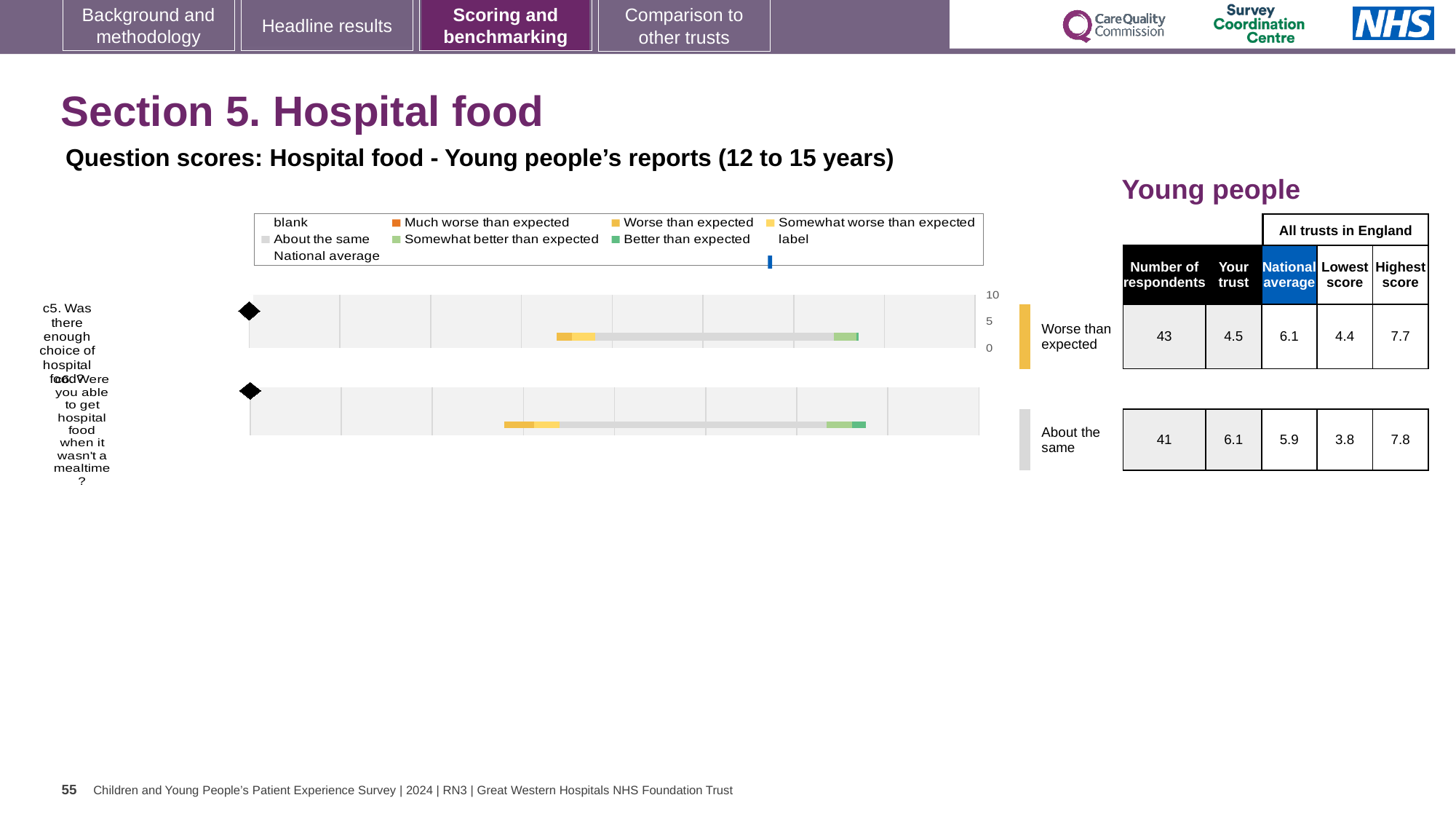
Which legend entry is shown with a blue marker in the chart legend? National average How many questions (bars) are plotted in the chart? 2 For question c6, is the 'Your trust' score or the national average score larger in the table beside the chart? Your trust What is the highest value shown on the chart's axis? 10 What is the difference between the highest score and the lowest score for question c5 in the table beside the chart? 3.3 What is the 'Your trust' score for question c5 in the table beside the chart? 4.5 According to the table beside the chart, what is the benchmark category for question c5 (enough choice of hospital food)? Worse than expected What kind of chart is shown on the slide? bar chart What is the difference between the highest score and the lowest score for question c6 in the table beside the chart? 4.0 How many respondents answered question c5 according to the table beside the chart? 43 According to the table beside the chart, what is the benchmark category for question c6 (getting hospital food when it wasn't a mealtime)? About the same What is the national average score for question c6 in the table beside the chart? 5.9